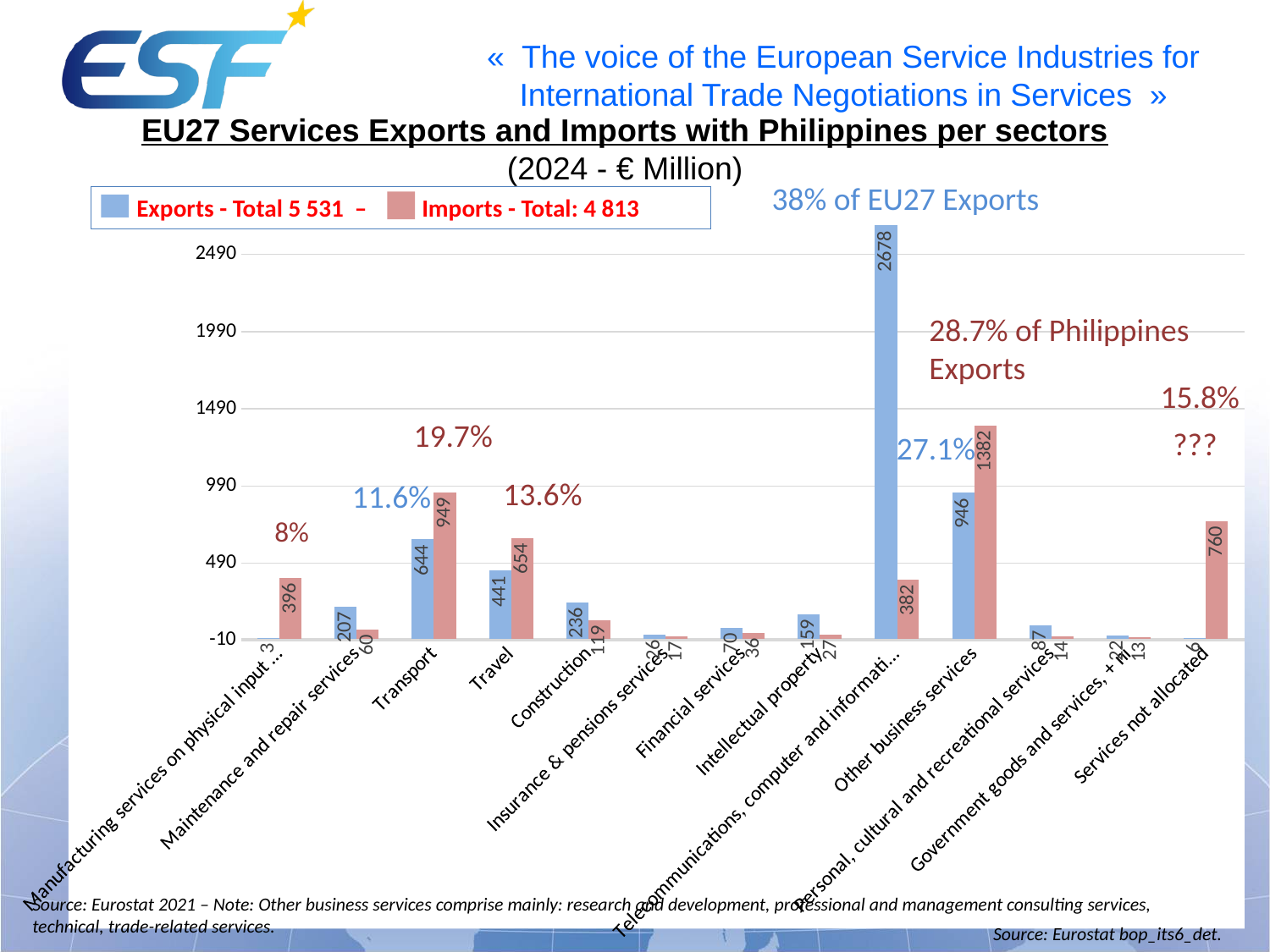
What is the value of Imports for Transport? 949 What is the value of Exports for Transport? 644 What is the value of Exports for Telecommunications, computer and information services? 2678 What is the value of Exports for Construction? 236 For Travel, which is larger, Exports or Imports? Imports How many series does the legend list? 2 What total for Exports is given in the legend? 5 531 Which sector has the highest Exports value? Telecommunications, computer and information services What is the difference between Imports and Exports for Other business services? 436 What is the value of Imports for Services not allocated? 760 Which sector has the highest Imports value? Other business services What kind of chart is shown on the slide? bar chart